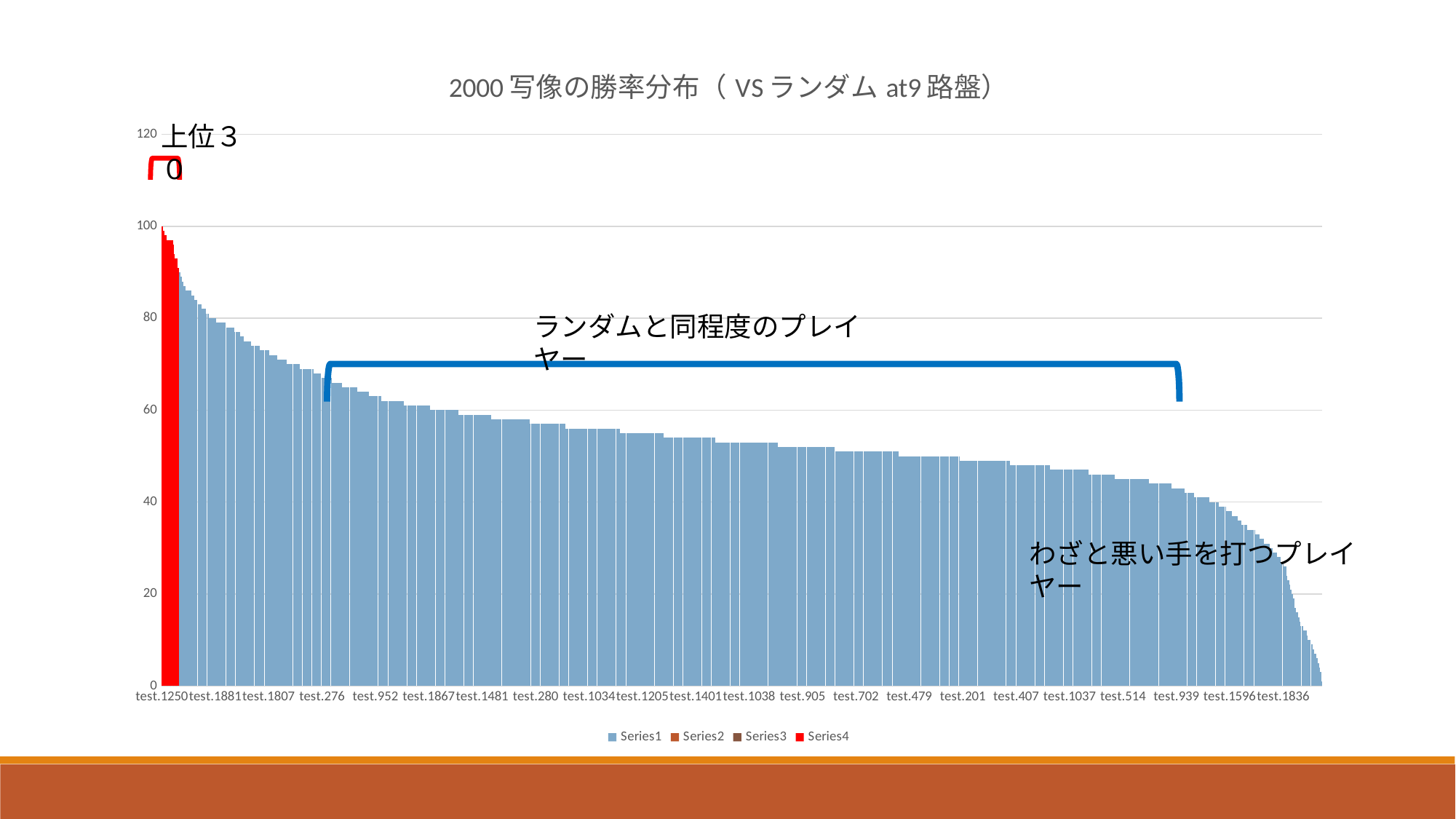
Is the value for test.1836 greater or less than 40? less What kind of chart is shown on the slide? bar chart Which has the larger value, test.1250 or test.1836? test.1250 What is the title of the chart? 2000写像の勝率分布（VSランダム at9路盤） Is the value for test.1250 greater or less than 80? greater Is the value for test.1807 greater or less than 60? greater Which of the labelled categories has the highest bar? test.1250 What colour are the bars for Series4 in the legend? red Do the bar values rise or fall from left to right along the x axis? fall Which of the labelled categories has the lowest bar? test.1836 How many series does the legend list? 4